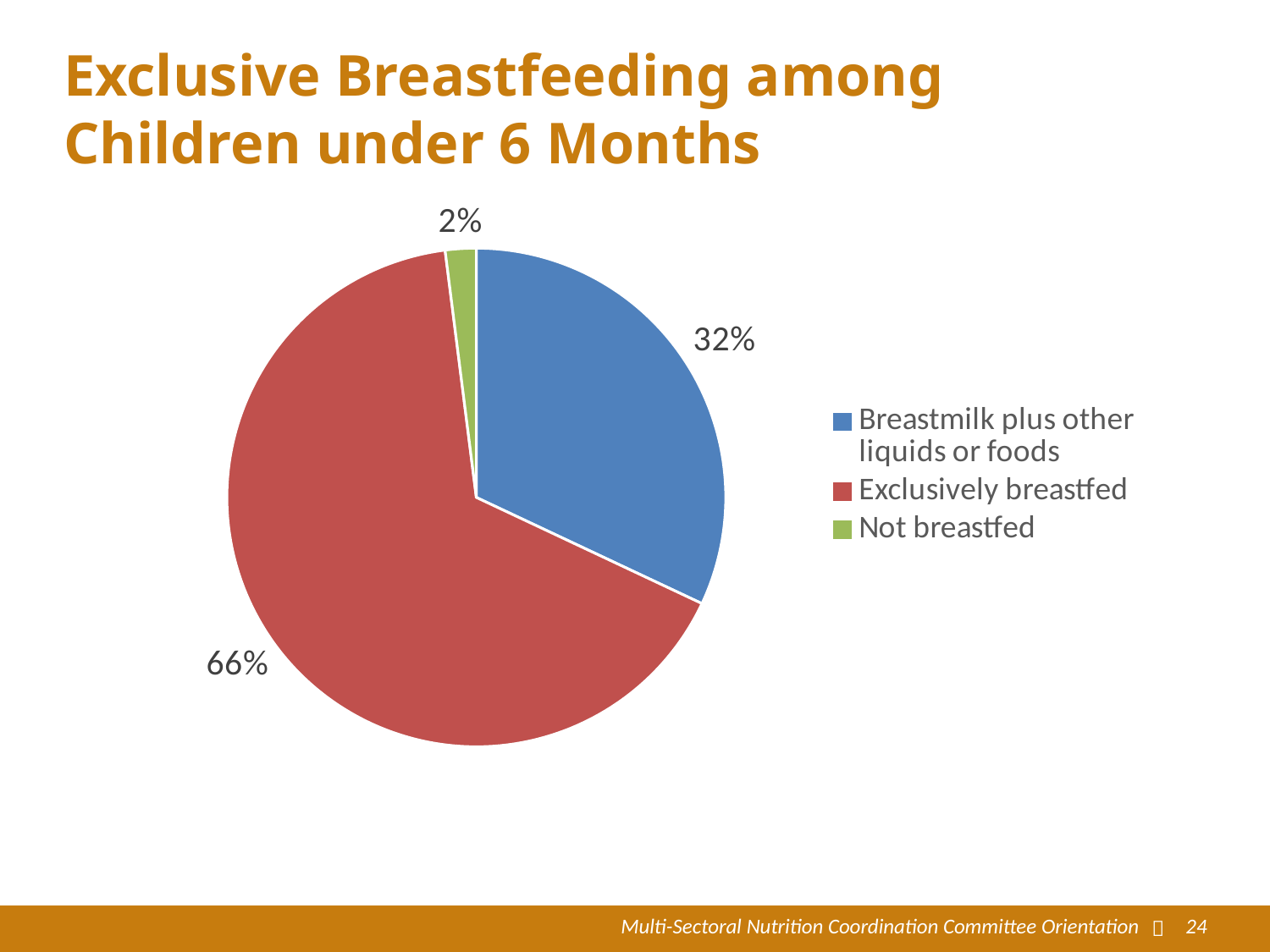
What share of the pie is labelled "Exclusively breastfed"? 66% Which is larger: the "Breastmilk plus other liquids or foods" slice or the "Not breastfed" slice? Breastmilk plus other liquids or foods Which category has the smallest slice of the pie? Not breastfed What kind of chart is shown on the slide? pie chart How many slices does the pie chart have? 3 What is the difference in percentage points between the "Exclusively breastfed" slice and the "Breastmilk plus other liquids or foods" slice? 34 What is the title of the slide containing the pie chart? Exclusive Breastfeeding among Children under 6 Months Which category has the largest slice of the pie? Exclusively breastfed How many entries does the legend list? 3 What share of the pie is labelled "Not breastfed"? 2% What colour is the "Exclusively breastfed" slice? red What share of the pie is labelled "Breastmilk plus other liquids or foods"? 32%